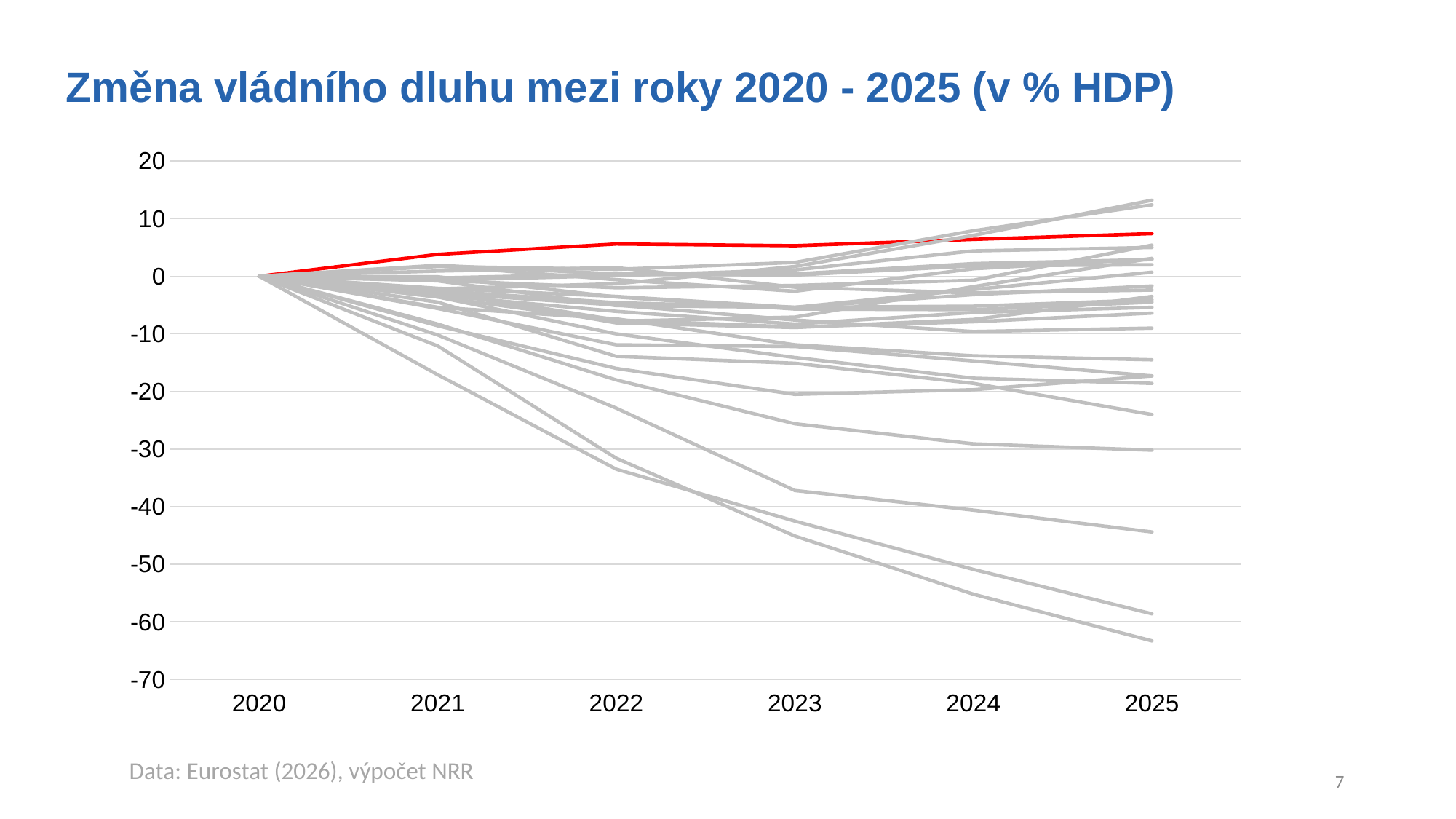
Does the red line rise or fall between 2020 and 2025? rise What is the title of the chart? Změna vládního dluhu mezi roky 2020 - 2025 (v % HDP) What colour is the highlighted line in the chart? red How many years are shown on the x axis of the chart? 6 Is the value of the red line in 2022 greater or less than 10? less What kind of chart is shown on the slide? line chart What is the value of the red line in 2020? 0 Is the value of the highest grey line in 2025 greater or less than 10? greater Is the value of the red line in 2025 greater or less than 10? less In 2025, is the red line higher or lower than the lowest grey line? higher